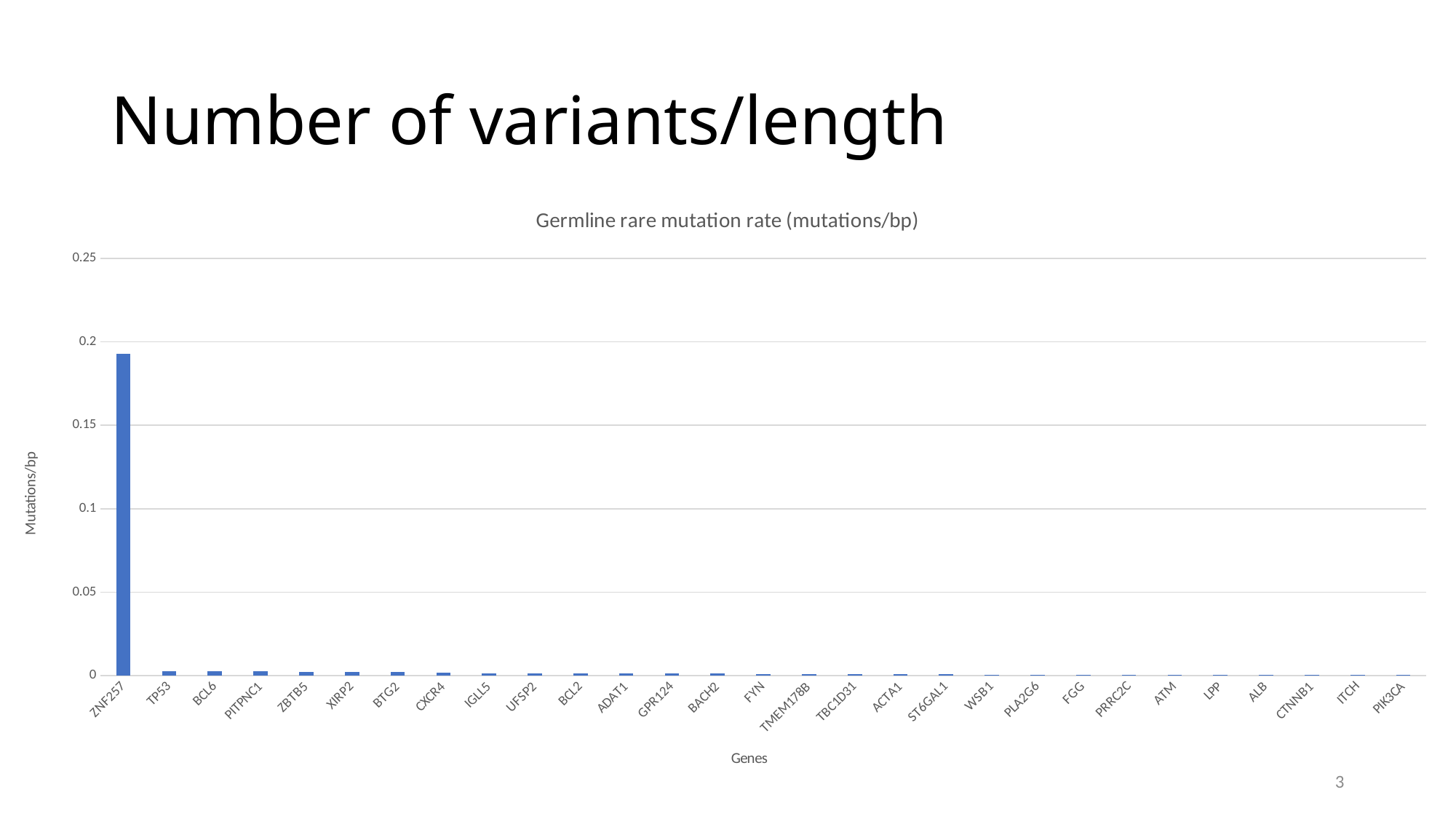
Is the value for ATM greater or less than 0.05? less Is the value for ZNF257 greater or less than 0.15? greater Is the value for ZNF257 greater or less than 0.2? less What is the label of the vertical axis? Mutations/bp How many genes are plotted on the x axis of the chart? 29 What is the title of the chart? Germline rare mutation rate (mutations/bp) Which has a larger value, BCL6 or PIK3CA? BCL6 Which gene has the highest mutation rate in the chart? ZNF257 Do the values generally rise or fall moving from left to right along the x axis? fall Which has a larger value, ZNF257 or TP53? ZNF257 What kind of chart is shown on the slide? bar chart